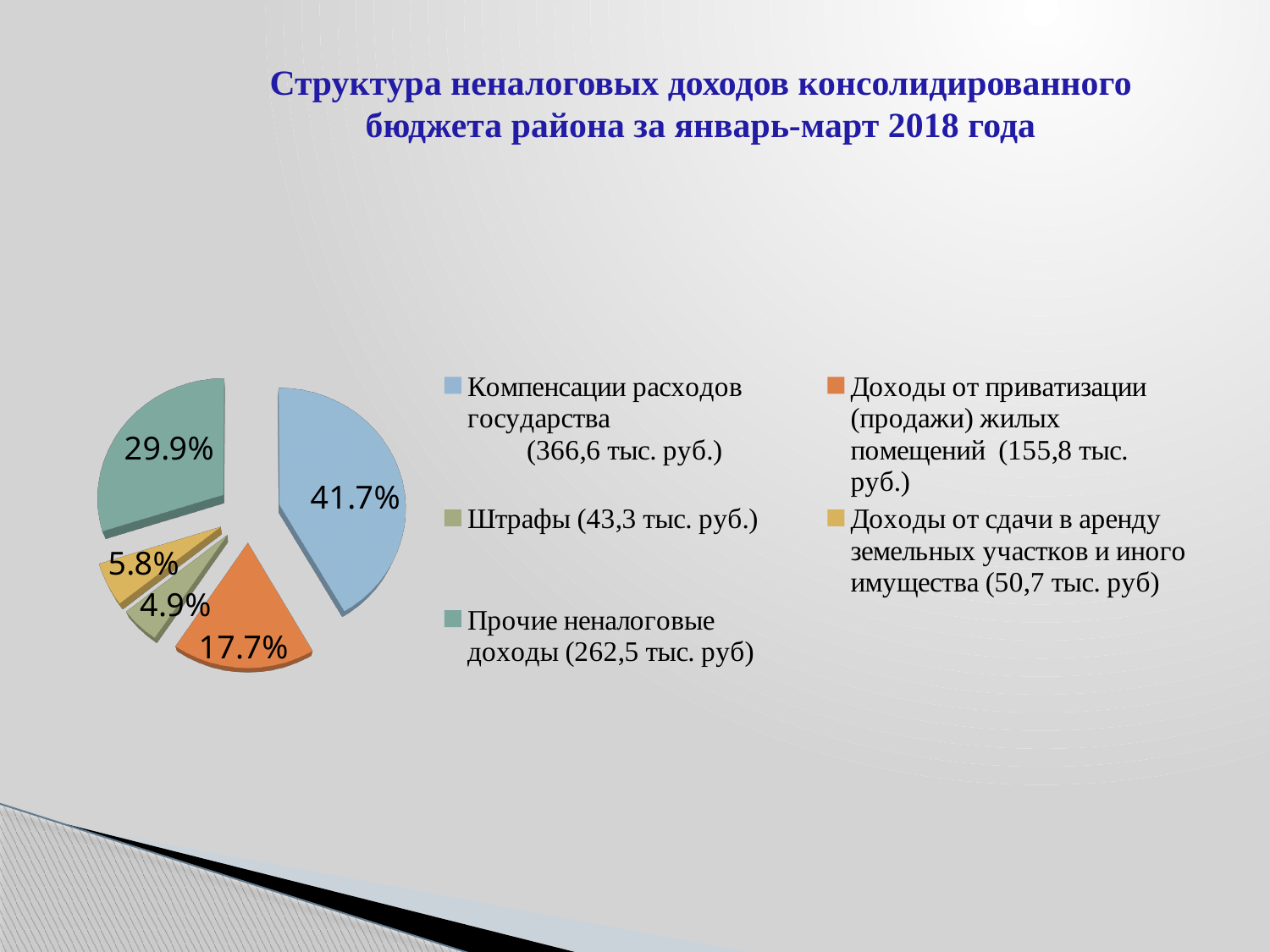
What share of the pie does "Штрафы" take? 4.9% Which category has the largest share of the pie? Компенсации расходов государства Which category has the smallest share of the pie? Штрафы What share of the pie does "Доходы от приватизации (продажи) жилых помещений" take? 17.7% What is the difference in percentage points between the shares of "Компенсации расходов государства" and "Прочие неналоговые доходы"? 11.8 What share of the pie does "Компенсации расходов государства" take? 41.7% What amount in thousand rubles does the legend give for "Штрафы"? 43,3 тыс. руб. How many slices does the pie chart have? 5 Which share is larger: "Доходы от приватизации (продажи) жилых помещений" or "Доходы от сдачи в аренду земельных участков и иного имущества"? Доходы от приватизации (продажи) жилых помещений What kind of chart is shown on the slide? pie chart